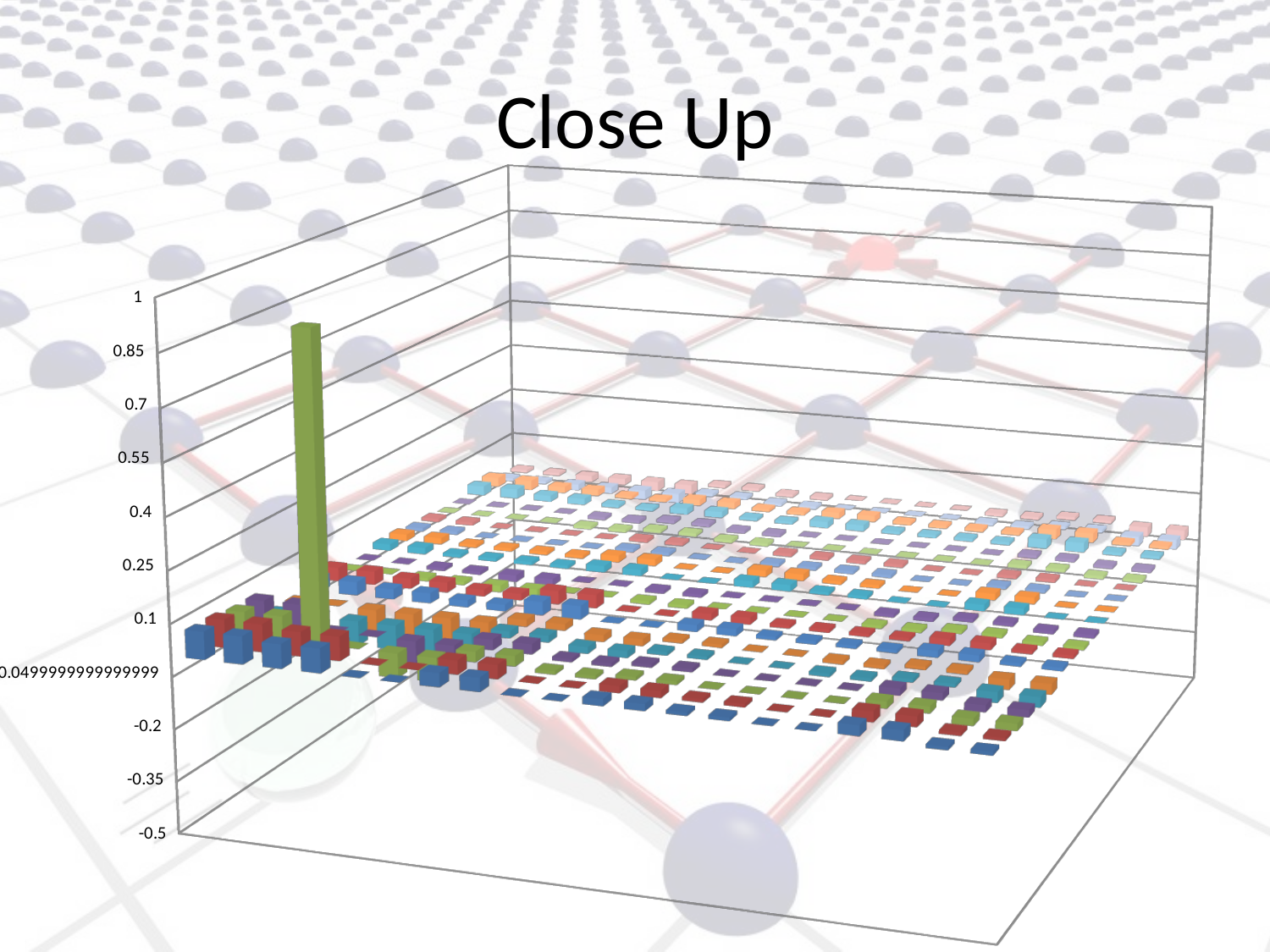
What kind of chart is shown on the slide? bar chart Is the value of the tallest bar in the chart greater or less than 0.55? greater Apart from the single tall green bar, are the remaining bars in the chart greater or less than 0.25? less What is the title of the slide containing the chart? Close Up Is the value of the tallest bar (the green one) greater or less than 0.7? greater What is the highest tick value shown on the vertical axis of the chart? 1